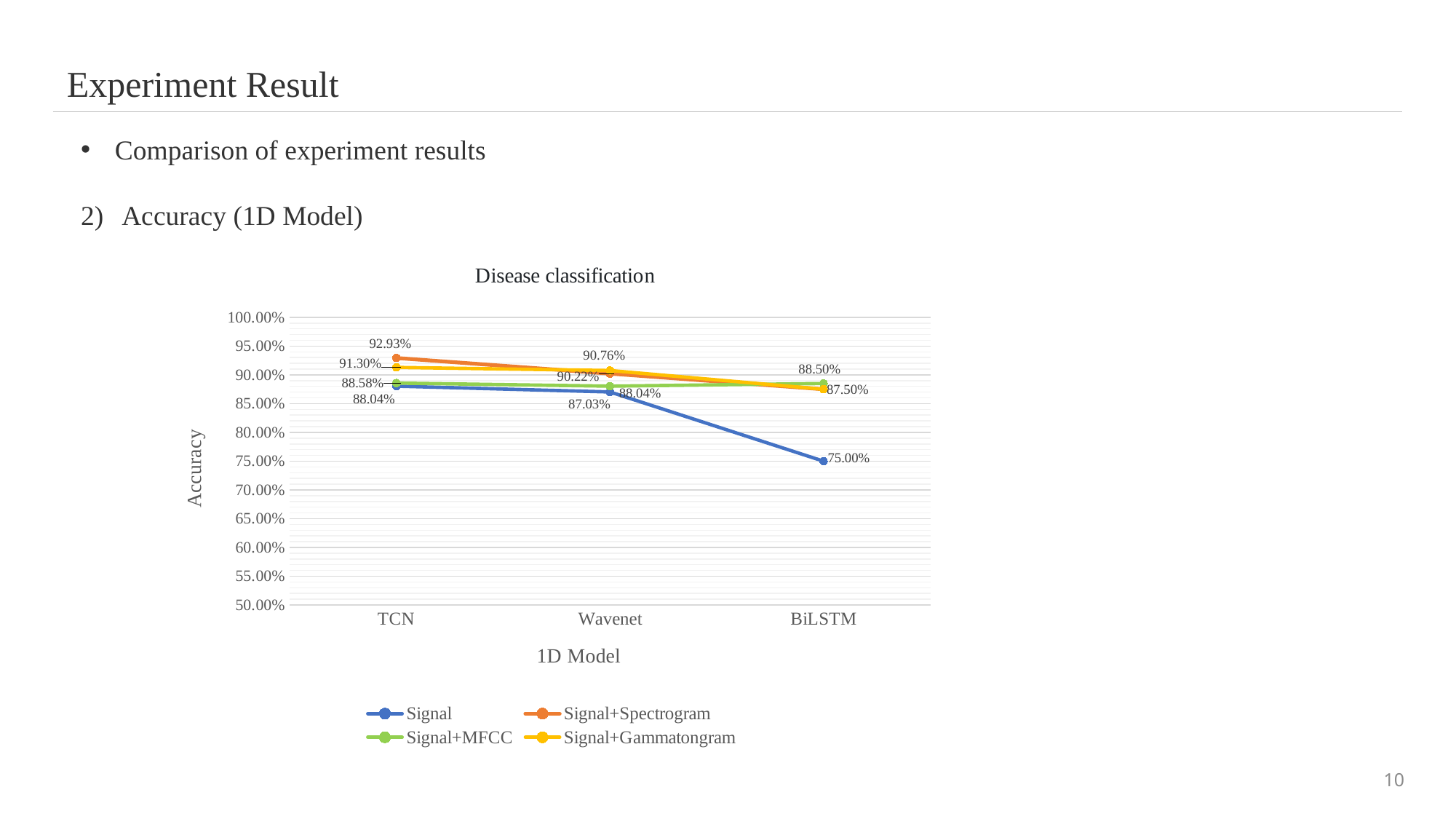
What is the accuracy of the Signal+Spectrogram series for TCN? 92.93% Does the Signal series rise or fall from TCN to BiLSTM? Fall What is the accuracy of the Signal+Gammatongram series for TCN? 91.30% How many 1D models are shown on the x axis? 3 What is the difference between the Signal+Spectrogram and Signal accuracies for TCN? 4.89% How many series does the legend list? 4 What is the title of the chart? Disease classification What type of chart is shown on the slide? Line chart What is the accuracy of the Signal+MFCC series for BiLSTM? 88.50% Which 1D model has the lowest accuracy for the Signal series? BiLSTM What is the accuracy of the Signal series for BiLSTM? 75.00% Which series has the highest accuracy for TCN? Signal+Spectrogram